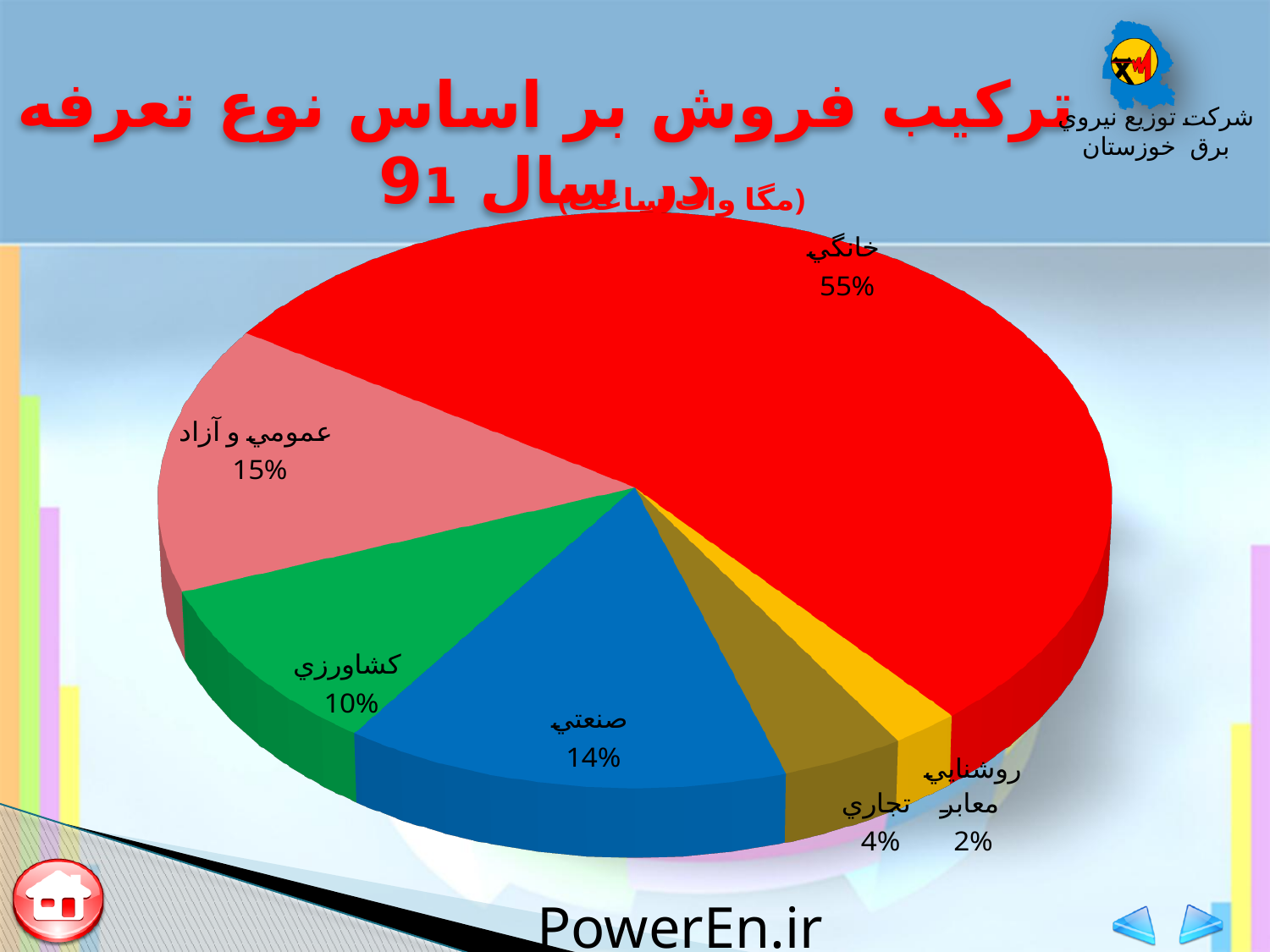
What is the value shown for the كشاورزي slice? 10% What is the difference in percentage points between the خانگي slice and the عمومي و آزاد slice? 40 What share of the pie does the خانگي slice represent? 55% What is the value shown for the صنعتي slice? 14% What is the value shown for the تجاري slice? 4% Which category has the smallest slice of the pie? روشنايي معابر How many slices does the pie chart have? 6 What is the value shown for the عمومي و آزاد slice? 15% Which category has the largest slice of the pie? خانگي Which is larger, the صنعتي slice or the كشاورزي slice? صنعتي What is the value shown for the روشنايي معابر slice? 2% What kind of chart is shown on the slide? pie chart